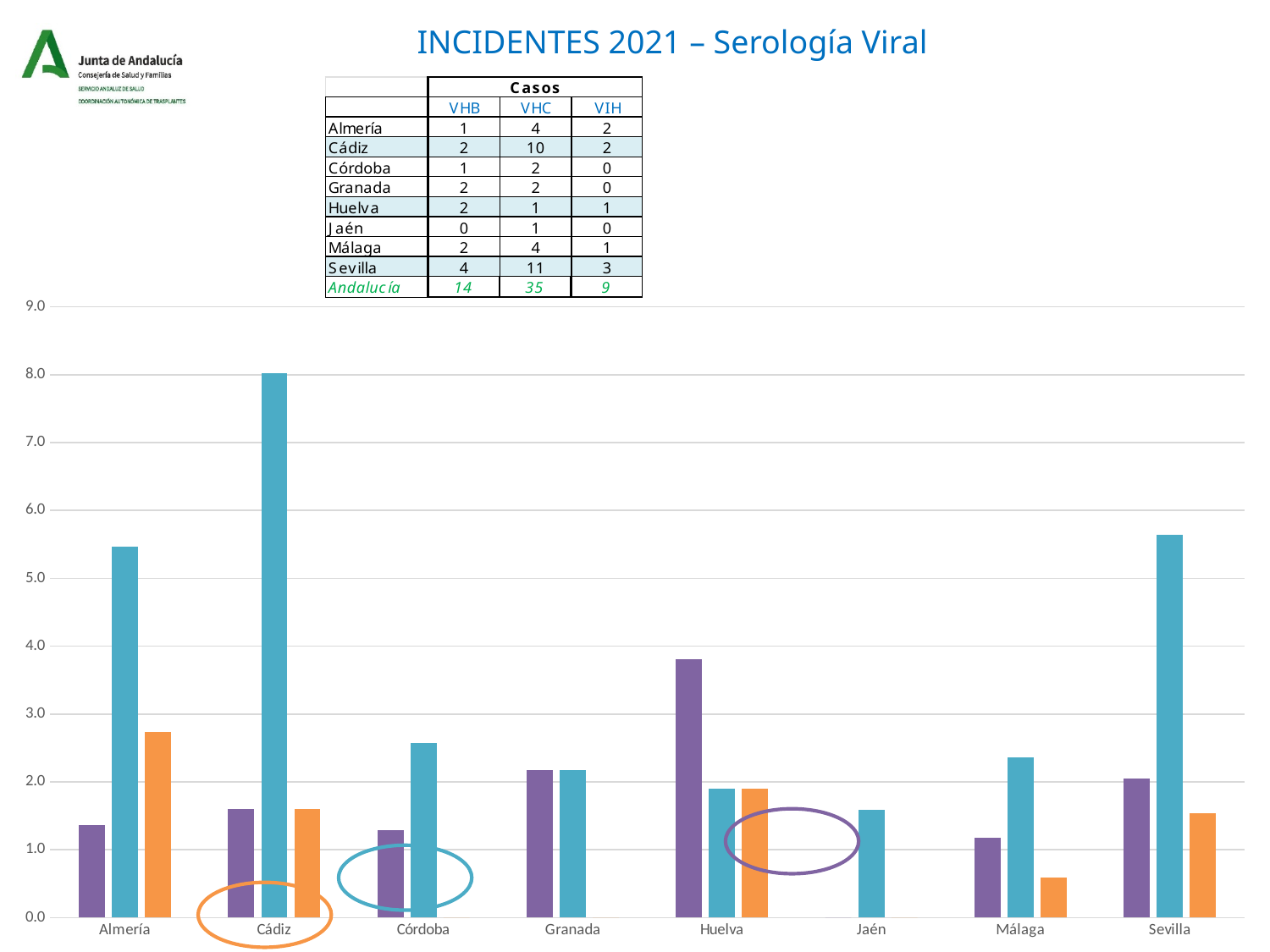
Which is taller, the purple bar for Huelva or the purple bar for Granada? Huelva What kind of chart is shown on the slide? bar chart Which is taller, the teal bar for Cádiz or the teal bar for Sevilla? Cádiz How many provinces are shown along the x axis of the chart? 8 Is the orange bar for Málaga greater or less than 1.0? less Which province has the tallest bar in the chart? Cádiz Which province has only a single (teal) bar in the chart? Jaén Is the tallest bar for Cádiz greater or less than 7.0? greater Is the purple bar for Huelva greater or less than 3.0? greater What is the highest value shown on the chart's y axis? 9.0